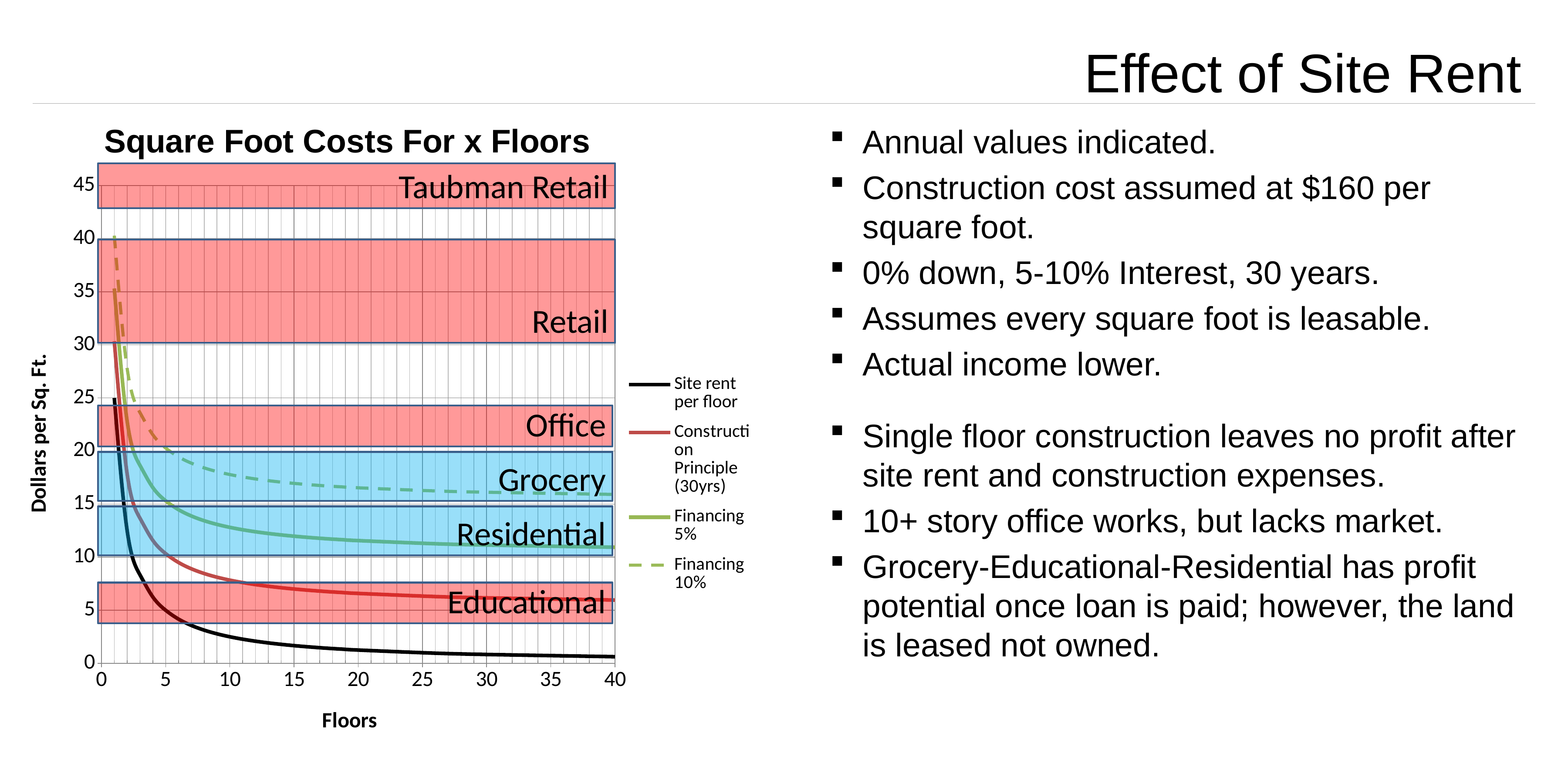
What is the title of the chart? Square Foot Costs For x Floors At 40 floors, which series has the higher value: Financing 10% or Financing 5%? Financing 10% Is the value of Financing 5% at 40 floors greater or less than 15? less How many series does the legend of the chart list? 4 Do the values of the Site rent per floor series rise or fall as the number of floors increases? Fall What is the label of the vertical axis of the chart? Dollars per Sq. Ft. Is the value of Construction Principle (30yrs) at 40 floors greater or less than 10? less Is the value of Site rent per floor at 40 floors greater or less than 5? less Which series has the lowest value at 40 floors? Site rent per floor Do the values of the Financing 10% series rise or fall as the number of floors increases? Fall What kind of chart is shown on the slide? Line chart